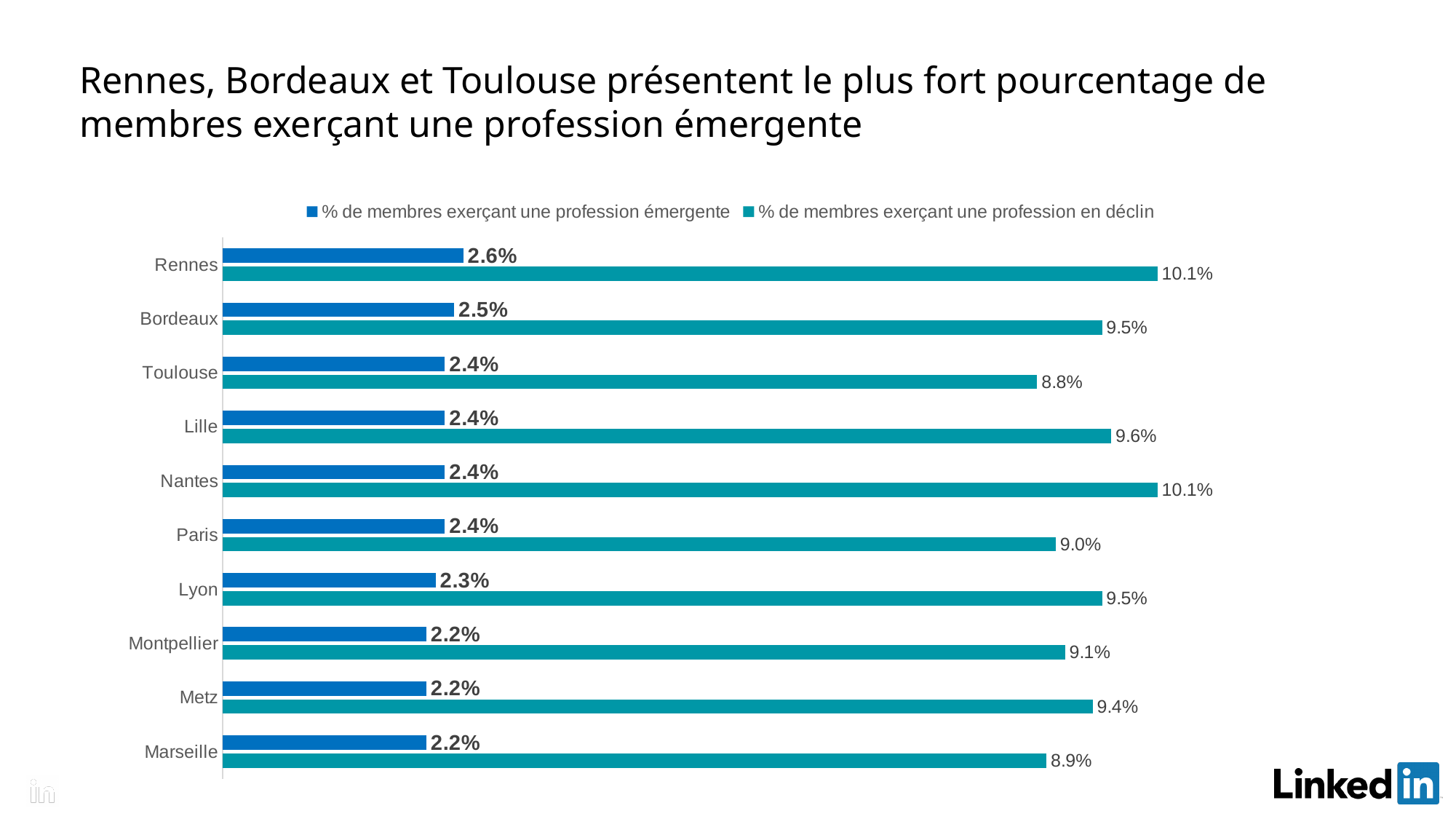
What kind of chart is shown on the slide? Bar chart Which city has the highest value in the series '% de membres exerçant une profession émergente'? Rennes Which legend entry is shown in the darker blue colour? % de membres exerçant une profession émergente What is the value for Rennes in the series '% de membres exerçant une profession émergente'? 2.6% How many cities are shown on the chart? 10 How many series does the legend list? 2 What is the value for Marseille in the series '% de membres exerçant une profession en déclin'? 8.9% What is the value for Toulouse in the series '% de membres exerçant une profession en déclin'? 8.8% Which is larger: the '% de membres exerçant une profession en déclin' value for Lille or for Lyon? Lille What is the difference between the two series values for Bordeaux? 7.0% What is the difference between the '% de membres exerçant une profession en déclin' values for Rennes and Paris? 1.1% Which city has the lowest value in the series '% de membres exerçant une profession en déclin'? Toulouse